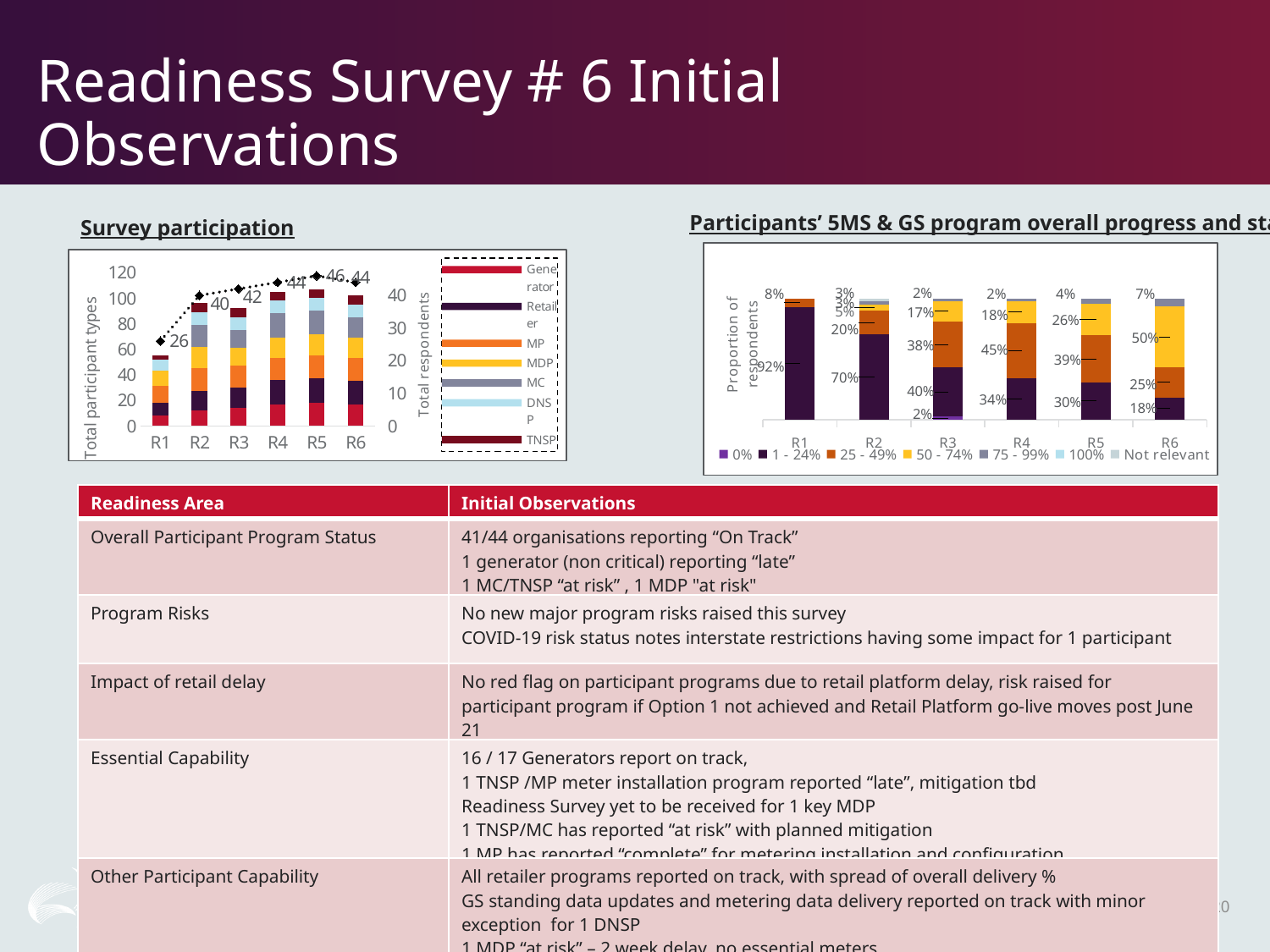
In the right-hand chart (Participants' 5MS & GS program overall progress), is the 25 - 49% share larger at R3 or at R4? R4 In the Survey participation chart, what is the total respondents value shown for R5? 46 What kind of chart is the right-hand chart (Participants' 5MS & GS program overall progress)? Stacked bar chart In the right-hand chart (Participants' 5MS & GS program overall progress), what proportion of respondents were in the 1 - 24% band at R1? 92% How many survey rounds are shown on the x axis of the Survey participation chart? 6 How many participant types does the legend of the Survey participation chart list? 7 In the right-hand chart (Participants' 5MS & GS program overall progress), does the 1 - 24% share rise or fall from R1 to R6? Fall In the Survey participation chart, what is the difference between the total respondents at R5 and at R1? 20 In the Survey participation chart, which round has the highest total respondents value on the dotted line? R5 In the Survey participation chart, what is the total respondents value shown for R1? 26 In the Survey participation chart, which round has the lowest total respondents value on the dotted line? R1 In the right-hand chart (Participants' 5MS & GS program overall progress), what proportion of respondents were in the 50 - 74% band at R6? 50%